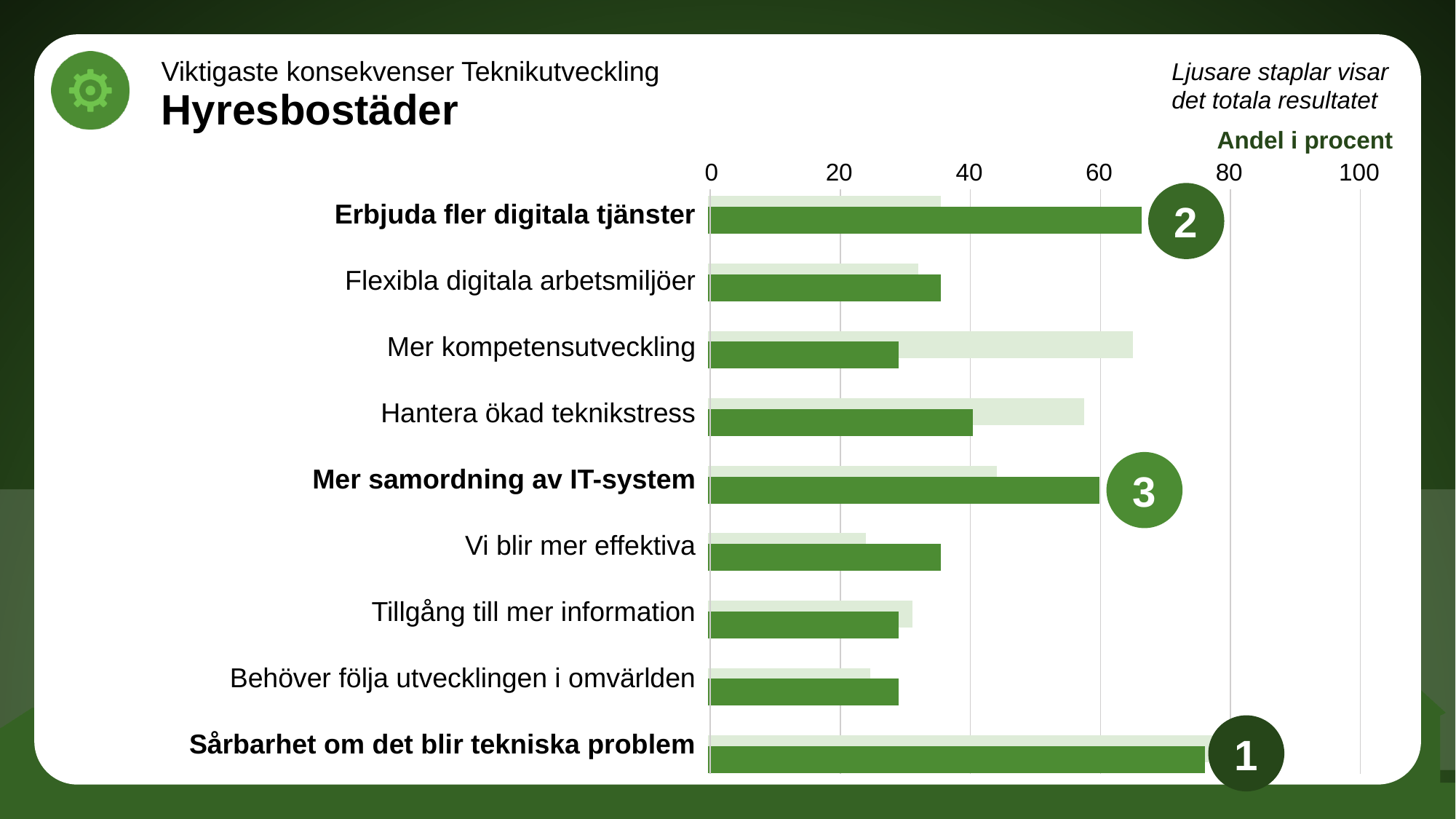
Which category has the longest dark green bar? Sårbarhet om det blir tekniska problem Which has the larger dark green bar: Erbjuda fler digitala tjänster or Mer kompetensutveckling? Erbjuda fler digitala tjänster Which has the larger light green bar: Mer kompetensutveckling or Vi blir mer effektiva? Mer kompetensutveckling Is the dark green bar for Hantera ökad teknikstress greater or less than 20? greater What is the label shown above the horizontal axis of the chart? Andel i procent How many categories are plotted in the chart? 9 Is the dark green bar for Sårbarhet om det blir tekniska problem greater or less than 80? less Is the dark green bar for Erbjuda fler digitala tjänster greater or less than 60? greater Which category is marked with the number 1 in the chart? Sårbarhet om det blir tekniska problem What kind of chart is shown on the slide? bar chart